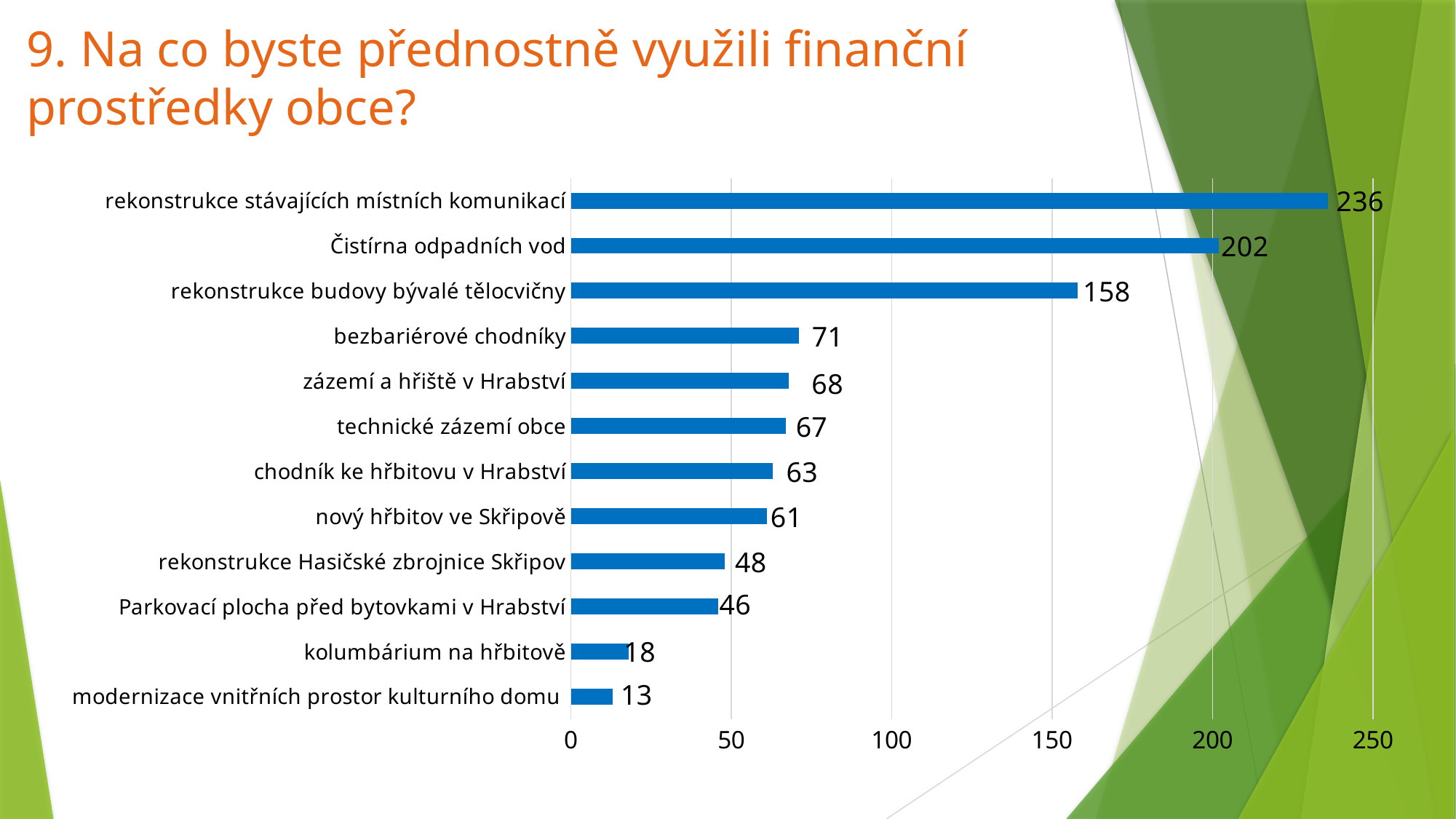
How many categories are shown in the chart? 12 Is the value for "rekonstrukce Hasičské zbrojnice Skřipov" greater or less than 50? less What is the value for "rekonstrukce stávajících místních komunikací"? 236 What is the title of the slide? 9. Na co byste přednostně využili finanční prostředky obce? Which category has the highest value? rekonstrukce stávajících místních komunikací What kind of chart is shown on the slide? bar chart What is the difference between the values for "bezbariérové chodníky" and "nový hřbitov ve Skřipově"? 10 Which is larger: the value for "rekonstrukce budovy bývalé tělocvičny" or the value for "bezbariérové chodníky"? rekonstrukce budovy bývalé tělocvičny What is the difference between the values for "rekonstrukce stávajících místních komunikací" and "Čistírna odpadních vod"? 34 Which category has the lowest value? modernizace vnitřních prostor kulturního domu What is the value for "Čistírna odpadních vod"? 202 What is the value for "kolumbárium na hřbitově"? 18